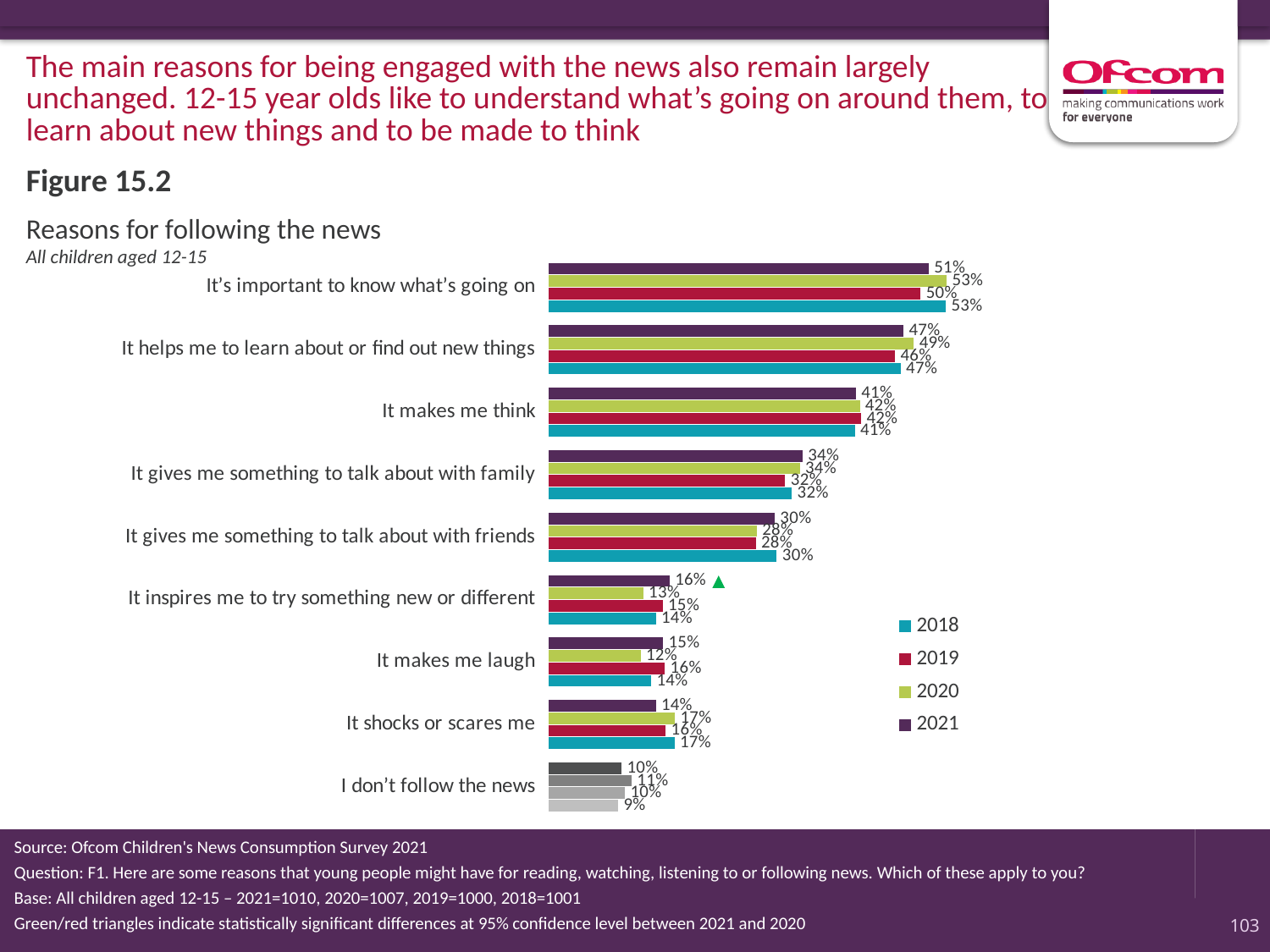
Which reason has the highest 2021 value? It's important to know what's going on What is the 2018 value for 'I don't follow the news'? 9% Which series is shown in purple in the legend? 2021 How many reasons (categories) are plotted in the chart? 9 What is the 2019 value for 'It makes me laugh'? 16% What is the difference between the 2021 and 2020 values for 'It inspires me to try something new or different'? 3 percentage points Which is larger for 'It shocks or scares me': the 2021 value or the 2020 value? 2020 What is the 2020 value for 'It helps me to learn about or find out new things'? 49% What is the 2021 value for 'It's important to know what's going on'? 51% Which reason has the lowest 2021 value? I don't follow the news What kind of chart is shown on the slide? bar chart How many series does the legend list? 4